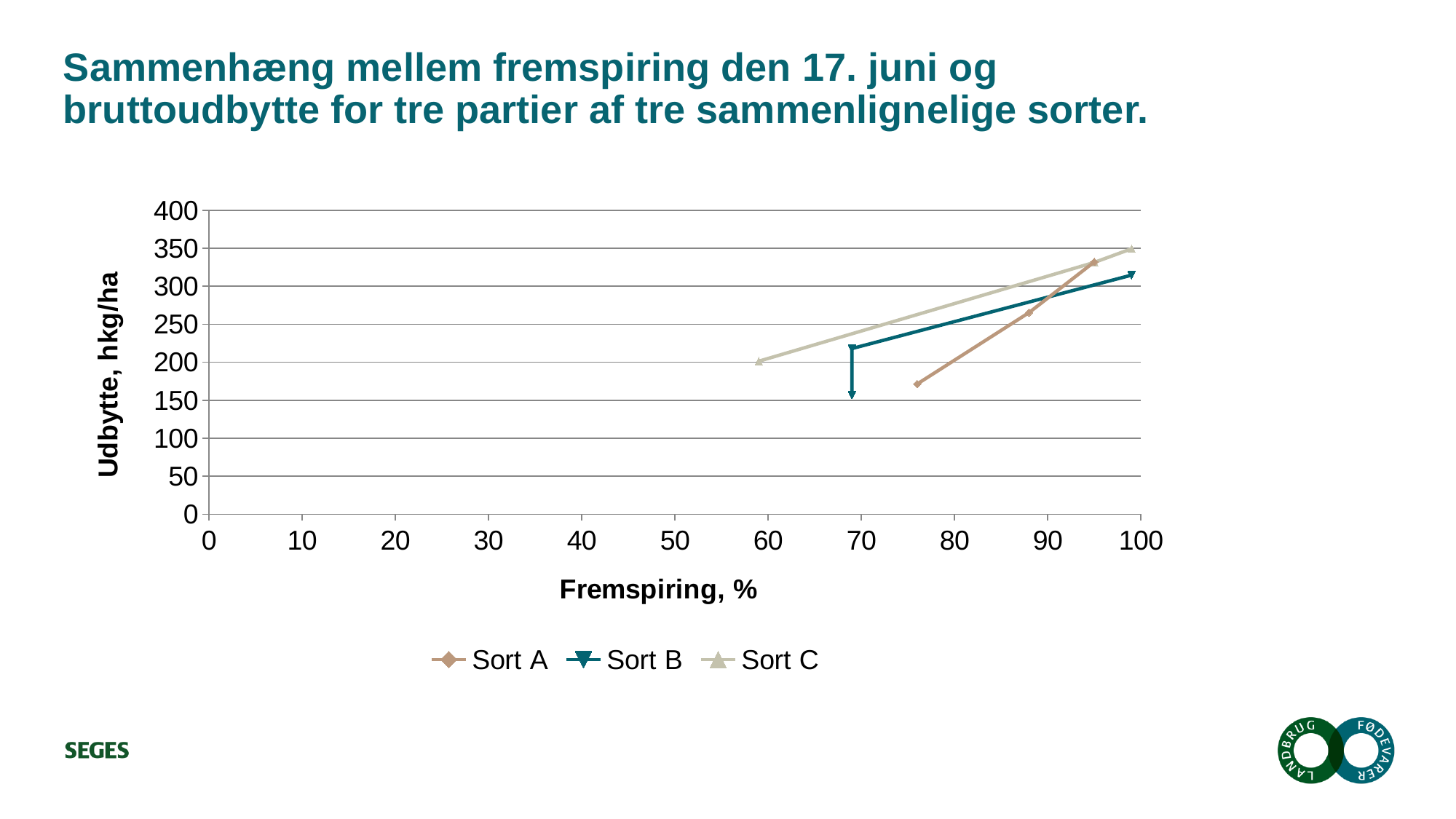
Is the lowest yield value for Sort B greater or less than 200? less Is the highest yield value for Sort C greater or less than 300? greater How many series does the legend list? 3 Is the lowest yield value for Sort A greater or less than 200? less Does the yield for Sort A rise or fall as emergence (Fremspiring) increases? rise What is the label of the y axis? Udbytte, hkg/ha What are the names of the series in the legend? Sort A, Sort B, Sort C At about 99% emergence, which series has the larger yield, Sort B or Sort C? Sort C How many data points are plotted for Sort A? 3 What kind of chart is shown on the slide? scatter chart with lines Which series reaches the highest yield on the chart? Sort C